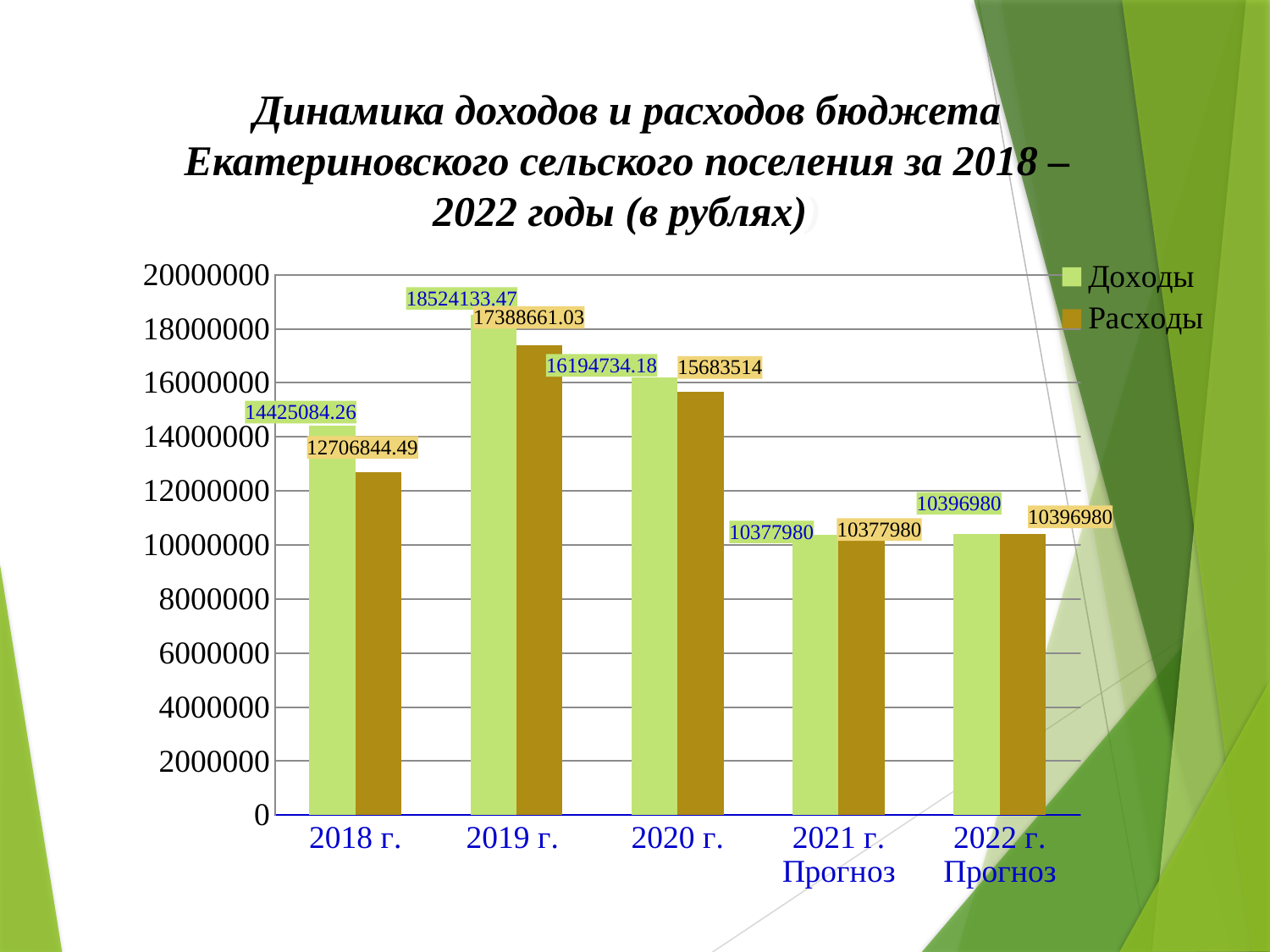
What is the difference between Доходы and Расходы for 2018 г.? 1718239.77 Which is larger for 2019 г., Доходы or Расходы? Доходы What is the value of Доходы for 2019 г.? 18524133.47 What kind of chart is shown on the slide? Bar chart How many year categories are shown on the x axis? 5 How many series does the legend list? 2 What is the value of Доходы for 2022 г. Прогноз? 10396980 What is the value of Расходы for 2020 г.? 15683514 What is the difference between Доходы and Расходы for 2020 г.? 511220.18 What is the value of Расходы for 2018 г.? 12706844.49 Which year has the highest value of Доходы? 2019 г. Which year has the lowest value of Расходы? 2021 г. Прогноз